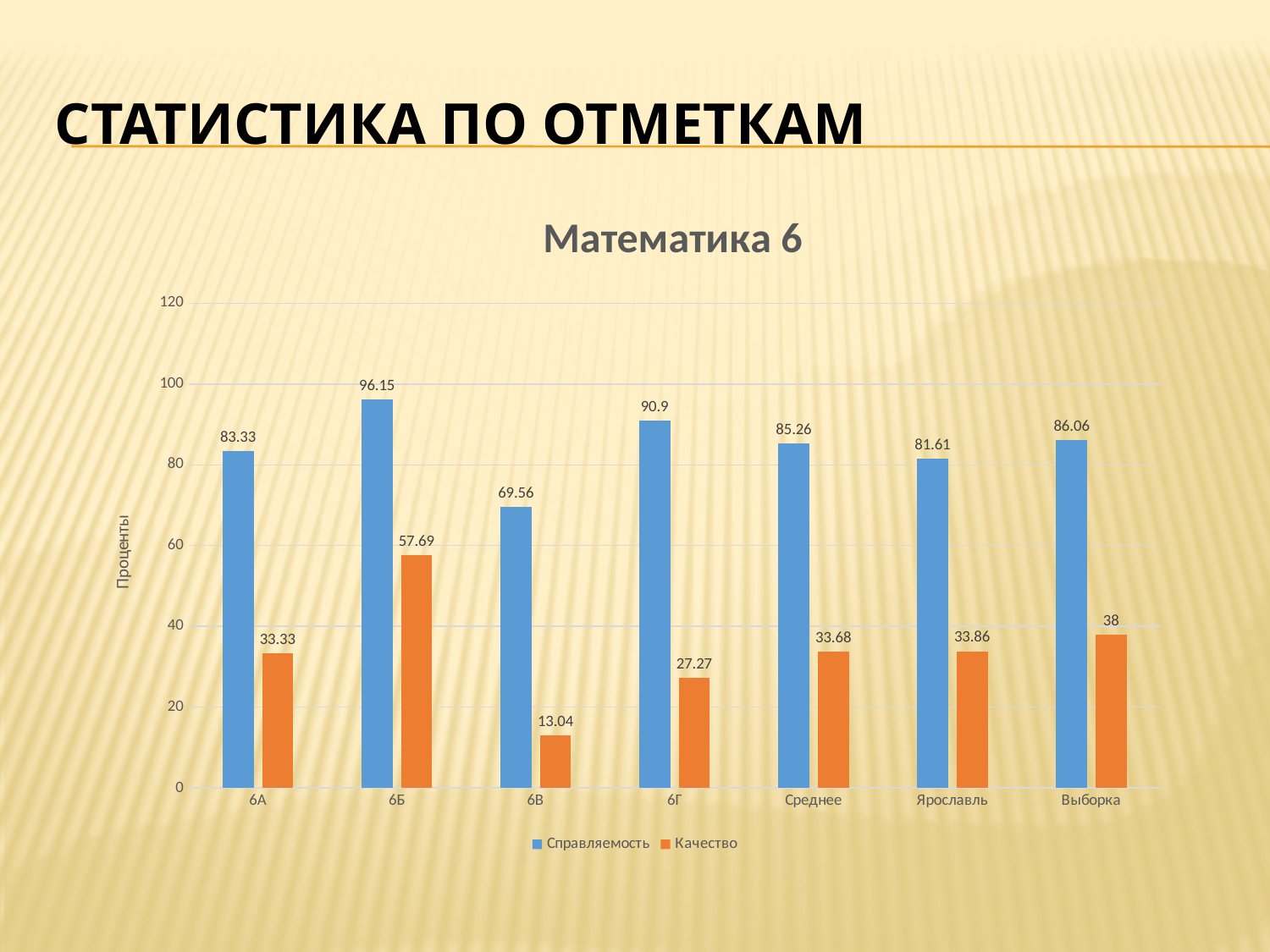
Which is larger, the Качество value for Среднее or for Ярославль? Ярославль What is the title of the chart? Математика 6 What kind of chart is shown? bar chart What is the Качество value for 6В? 13.04 Which category has the highest Справляемость value? 6Б What is the Справляемость value for 6Б? 96.15 Which category has the lowest Качество value? 6В Is the Справляемость value for 6В greater or less than 80? less What is the Качество value for Выборка? 38 What is the difference between the Справляемость and Качество values for 6А? 50 How many series does the legend list? 2 How many categories are shown on the x axis? 7